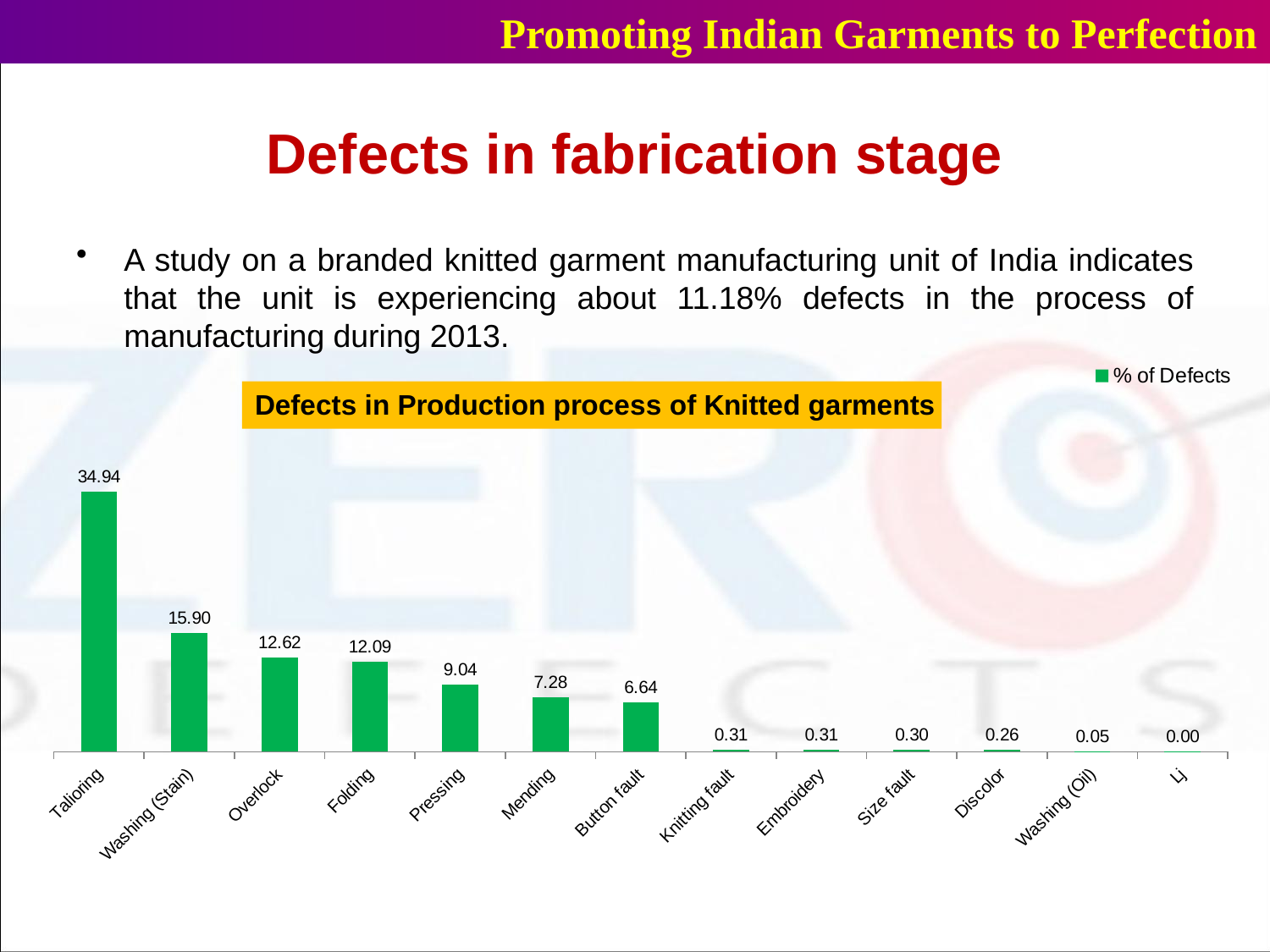
Which is larger, the value for Mending or the value for Button fault? Mending Which category has the lowest value? Lj What is the value for Button fault? 6.64 What is the value for Washing (Stain)? 15.90 What is the difference between the values for Talioring and Washing (Stain)? 19.04 How many series does the legend list? 1 Which category has the highest value? Talioring What is the value for Pressing? 9.04 What kind of chart is shown on the slide? Bar chart How many categories are shown on the x axis? 13 What is the value for Discolor? 0.26 What is the difference between the values for Overlock and Folding? 0.53